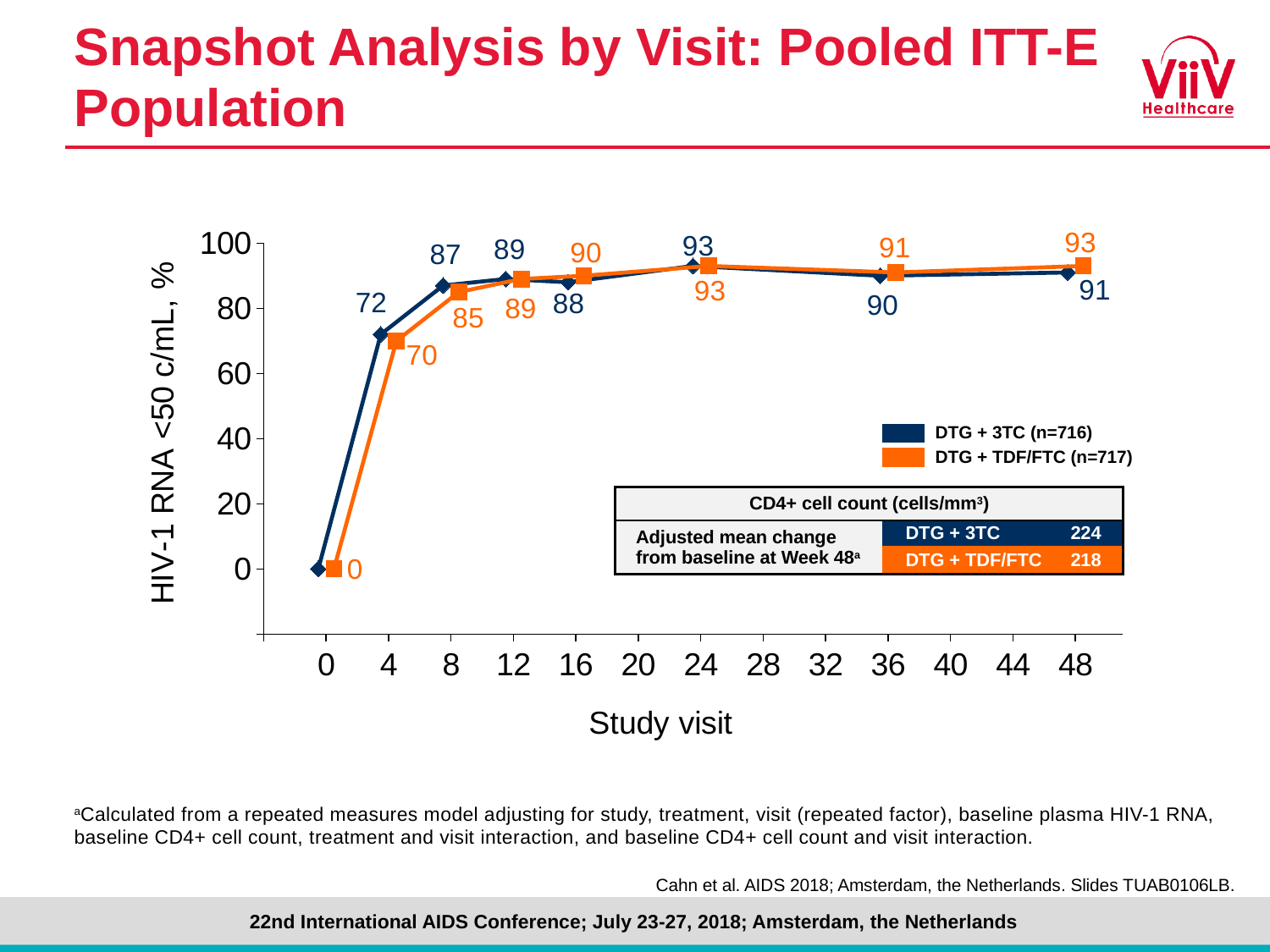
What is the value for DTG + 3TC at study visit week 48? 91 What is the value for DTG + TDF/FTC at study visit week 8? 85 How many series does the legend list? 2 Do the values for DTG + 3TC rise or fall between week 0 and week 8? Rise What is the value for DTG + 3TC at study visit week 4? 72 Which series has the larger value at week 16, DTG + 3TC or DTG + TDF/FTC? DTG + TDF/FTC What kind of chart is shown on the slide? Line chart How many data points are plotted for the DTG + TDF/FTC series? 8 At which study visit does the DTG + 3TC series reach its highest value? 24 What is the difference between the DTG + 3TC and DTG + TDF/FTC values at week 4? 2 What is the value for DTG + TDF/FTC at study visit week 36? 91 Which series has the larger value at week 8, DTG + 3TC or DTG + TDF/FTC? DTG + 3TC